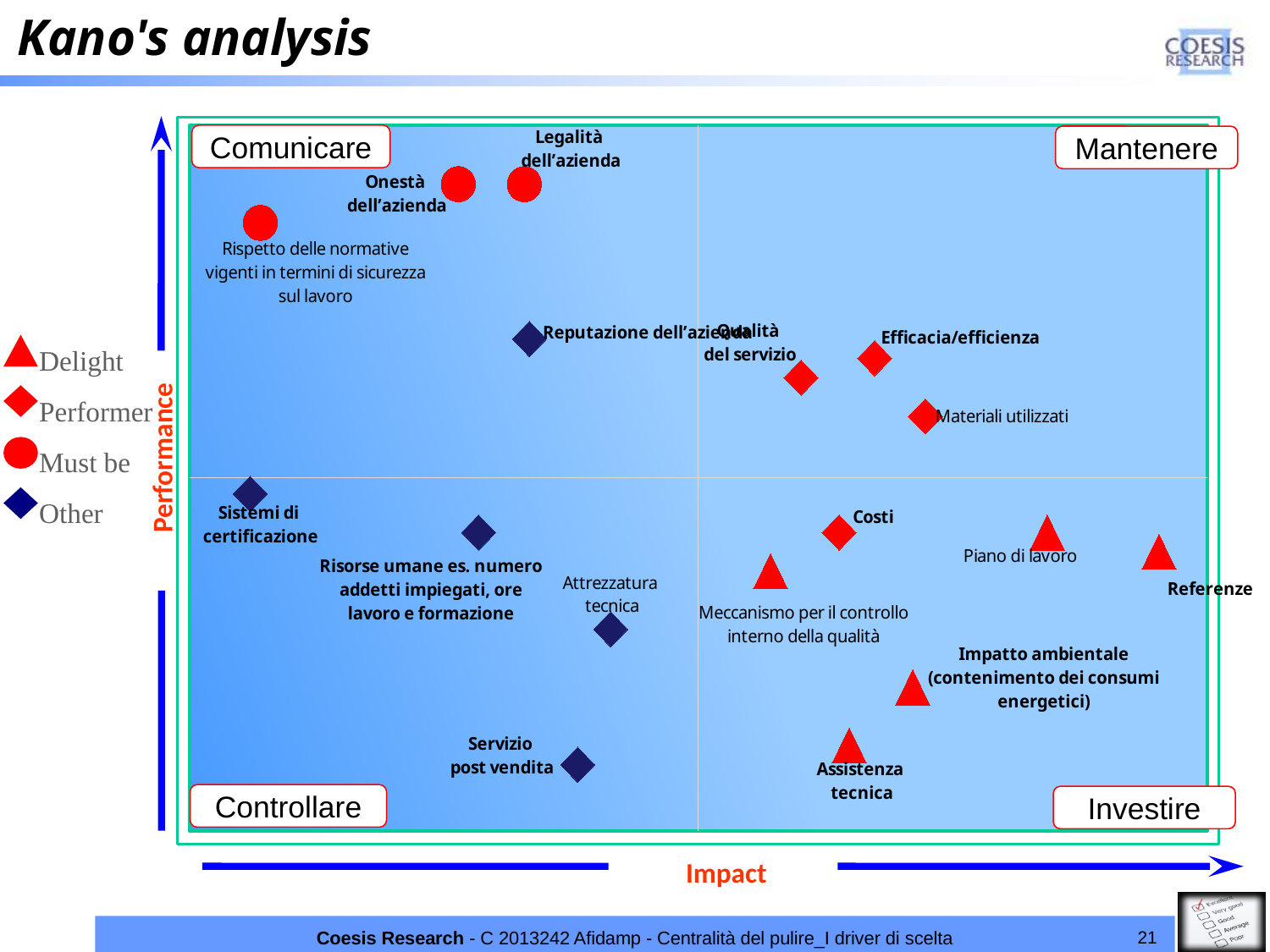
Which has the higher Impact value, 'Referenze' or 'Sistemi di certificazione'? Referenze How many points are plotted in total on the chart? 17 What kind of chart is shown on the slide? scatter chart How many points belong to the 'Delight' series (red triangles)? 5 Which has the higher Performance value, 'Legalità dell'azienda' or 'Servizio post vendita'? Legalità dell'azienda How many points belong to the 'Must be' series (red circles)? 3 In which quadrant does the point 'Onestà dell'azienda' fall? Comunicare What is the label of the horizontal axis? Impact In which quadrant does the point 'Referenze' fall? Investire How many series does the legend list? 4 Which series does the point 'Costi' belong to? Performer Which point has the highest Impact value? Referenze